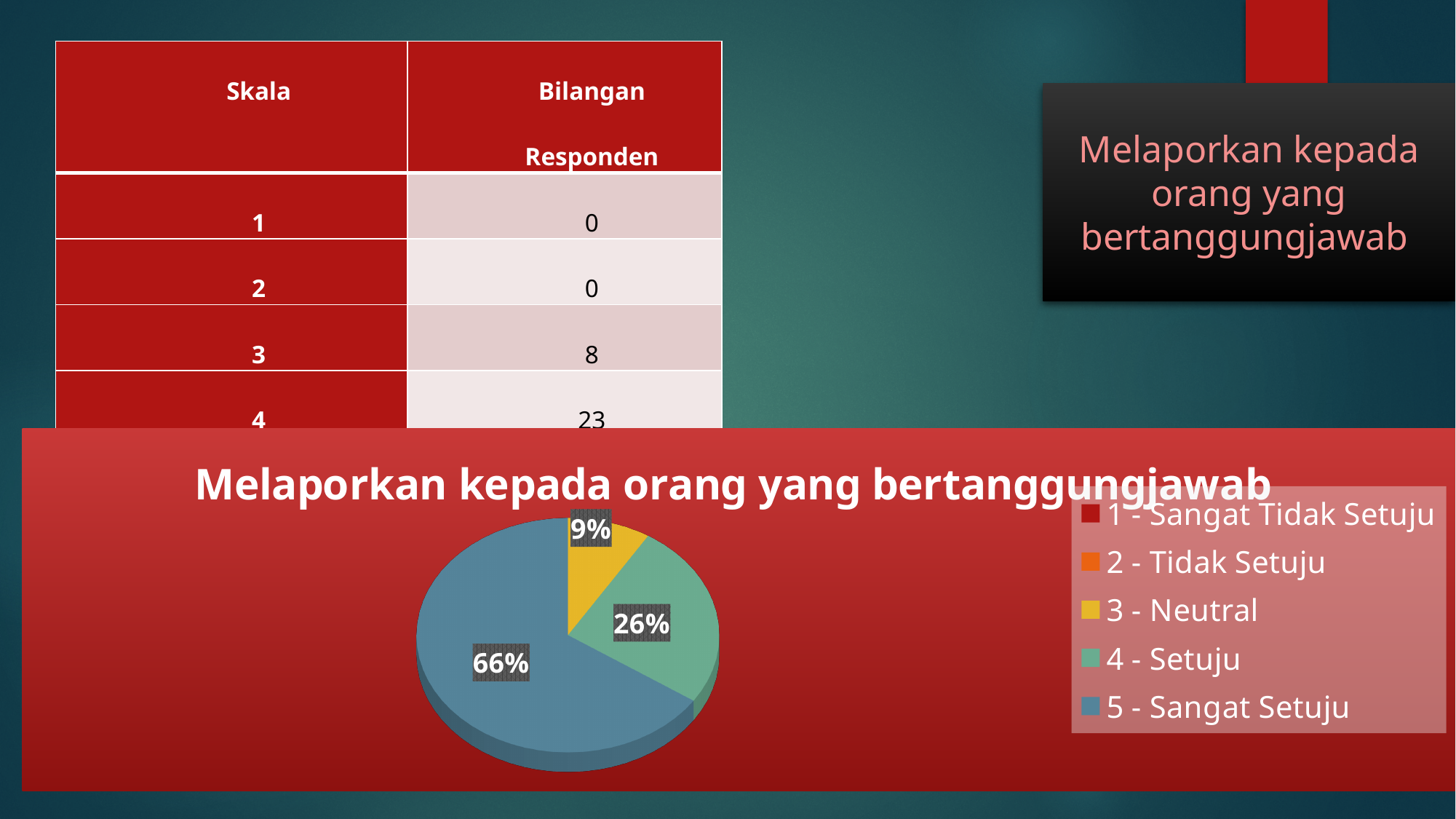
What colour is the 5 - Sangat Setuju slice in the pie chart? blue Which slice is larger in the pie chart, 4 - Setuju or 3 - Neutral? 4 - Setuju What percentage of the pie chart is labelled for 5 - Sangat Setuju? 66% What type of chart is shown on the slide? pie chart What percentage of the pie chart is labelled for 4 - Setuju? 26% Which labelled slice in the pie chart is the smallest? 3 - Neutral What is the difference in percentage points between the 5 - Sangat Setuju slice and the 4 - Setuju slice? 40 How many entries does the legend of the pie chart list? 5 What percentage of the pie chart is labelled for 3 - Neutral? 9% How many slices with percentage labels are visible in the pie chart? 3 Which category has the largest slice in the pie chart? 5 - Sangat Setuju What is the title of the pie chart? Melaporkan kepada orang yang bertanggungjawab